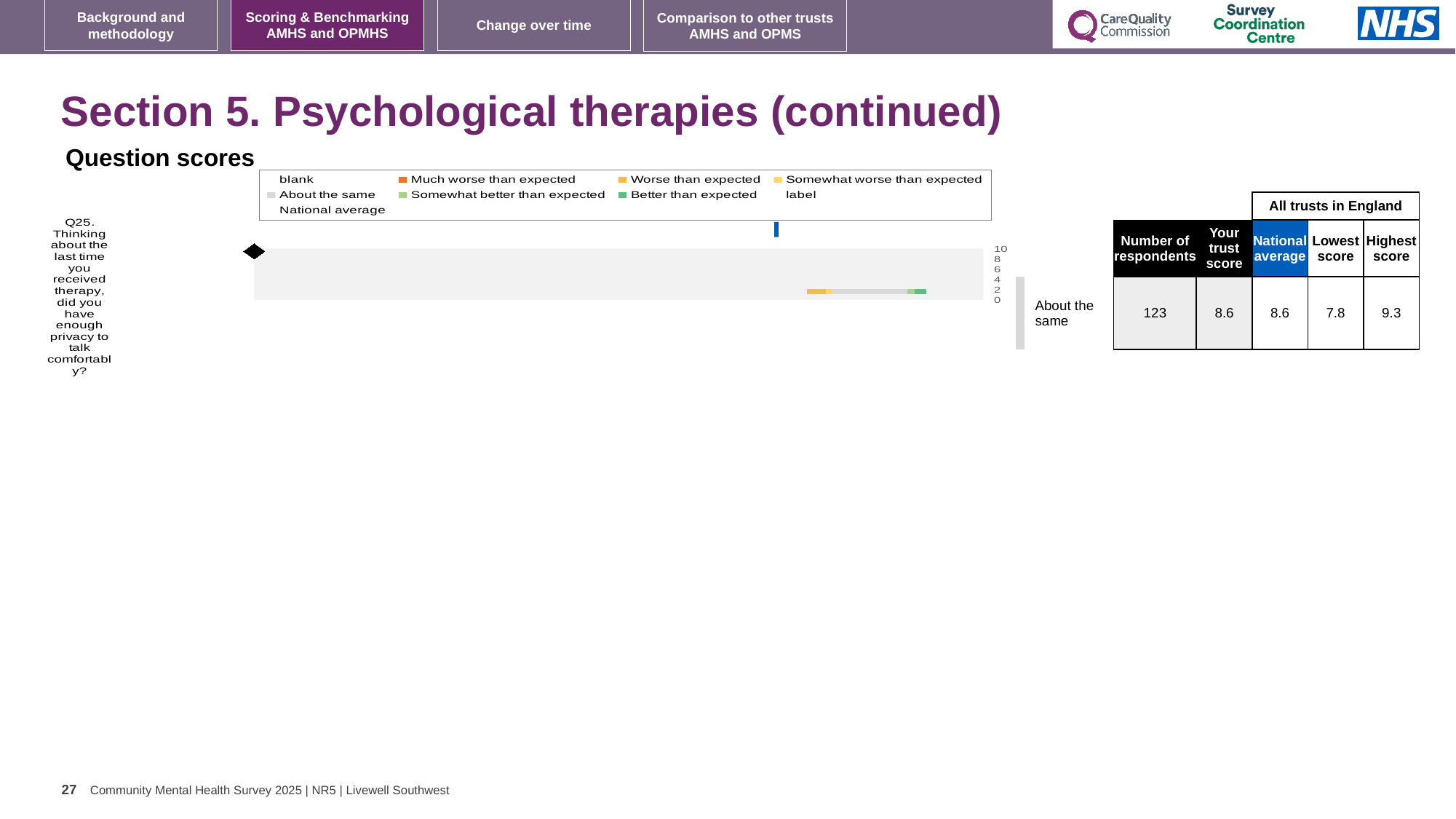
How many respondents are listed for Q25? 123 What is the national average score for Q25? 8.6 What kind of chart is shown under 'Question scores'? bar chart Which is larger for Q25: the highest score or the national average? highest score What is the lowest score among all trusts in England for Q25? 7.8 Which survey question is plotted in the chart? Q25 What is the difference between the highest and lowest trust scores for Q25? 1.5 Is the trust's score for Q25 greater or less than 8? greater What benchmark category is shown next to the bar for Q25? About the same What is the highest score among all trusts in England for Q25? 9.3 What is the trust's score for Q25? 8.6 What is the highest value shown on the chart's score axis? 10